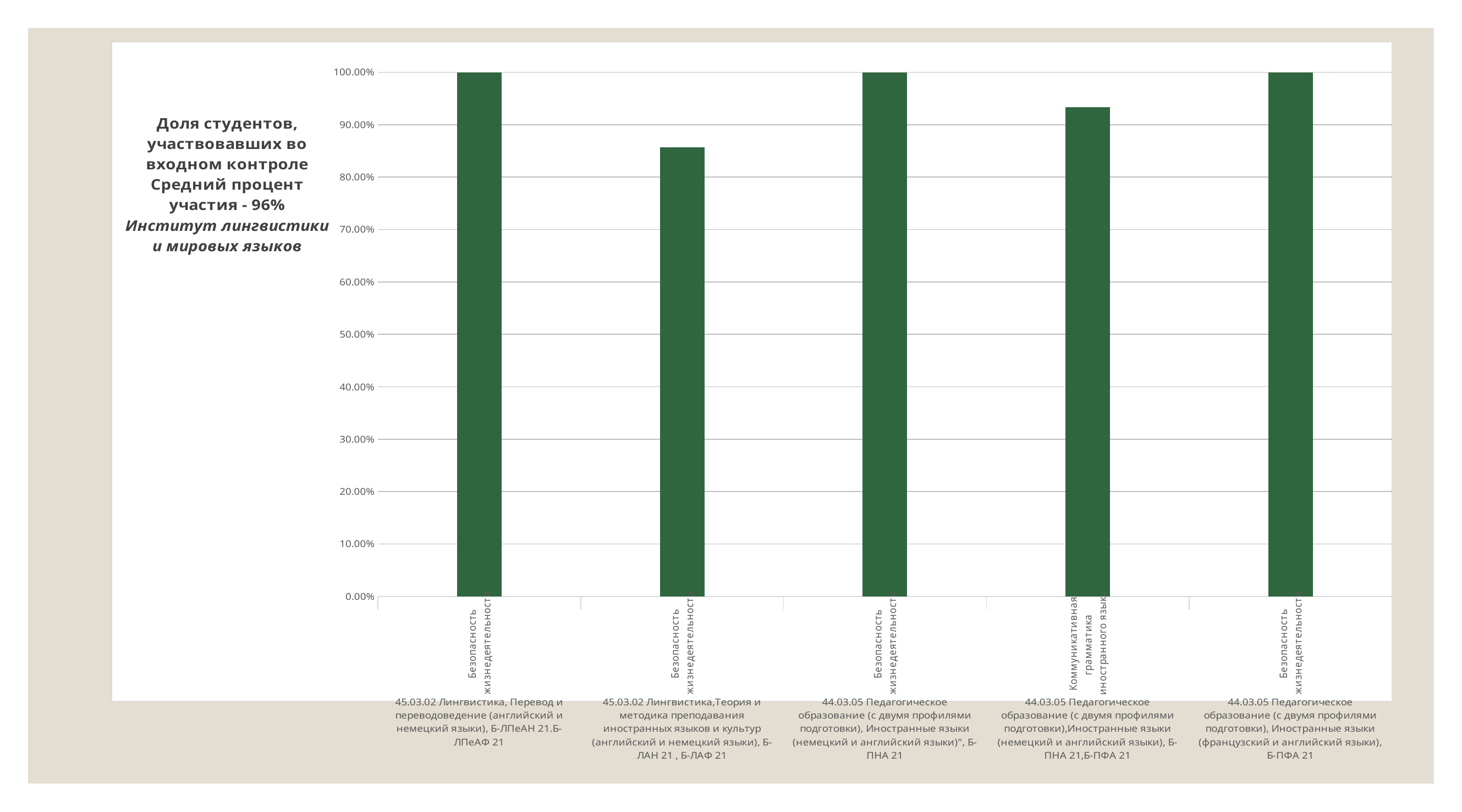
How many bars (categories) are plotted in the chart? 5 According to the chart title, what is the average participation percentage (Средний процент участия)? 96% What is the value for the group Б-ПФА 21 (французский и английский языки) in Безопасность жизнедеятельности? 100.00% Is the value for the group Б-ЛАН 21, Б-ЛАФ 21 greater or less than 80.00%? greater What is the value for the group Б-ПНА 21 (44.03.05 Педагогическое образование, немецкий и английский языки) in Безопасность жизнедеятельности? 100.00% What is the value for the group Б-ЛПеАН 21.Б-ЛПеАФ 21 (45.03.02 Лингвистика, Перевод и переводоведение)? 100.00% Is the value for the group Б-ЛАН 21, Б-ЛАФ 21 greater or less than 90.00%? less How many bars reach 100.00%? 3 Which category has the lowest value in the chart? 45.03.02 Лингвистика, Теория и методика преподавания иностранных языков и культур, Б-ЛАН 21, Б-ЛАФ 21 Which is larger: the value for Б-ЛАН 21, Б-ЛАФ 21 or the value for Коммуникативная грамматика иностранного языка (Б-ПНА 21, Б-ПФА 21)? Коммуникативная грамматика иностранного языка (Б-ПНА 21, Б-ПФА 21) Is the value for Коммуникативная грамматика иностранного языка (Б-ПНА 21, Б-ПФА 21) greater or less than 90.00%? greater What kind of chart is shown on the slide? Bar chart